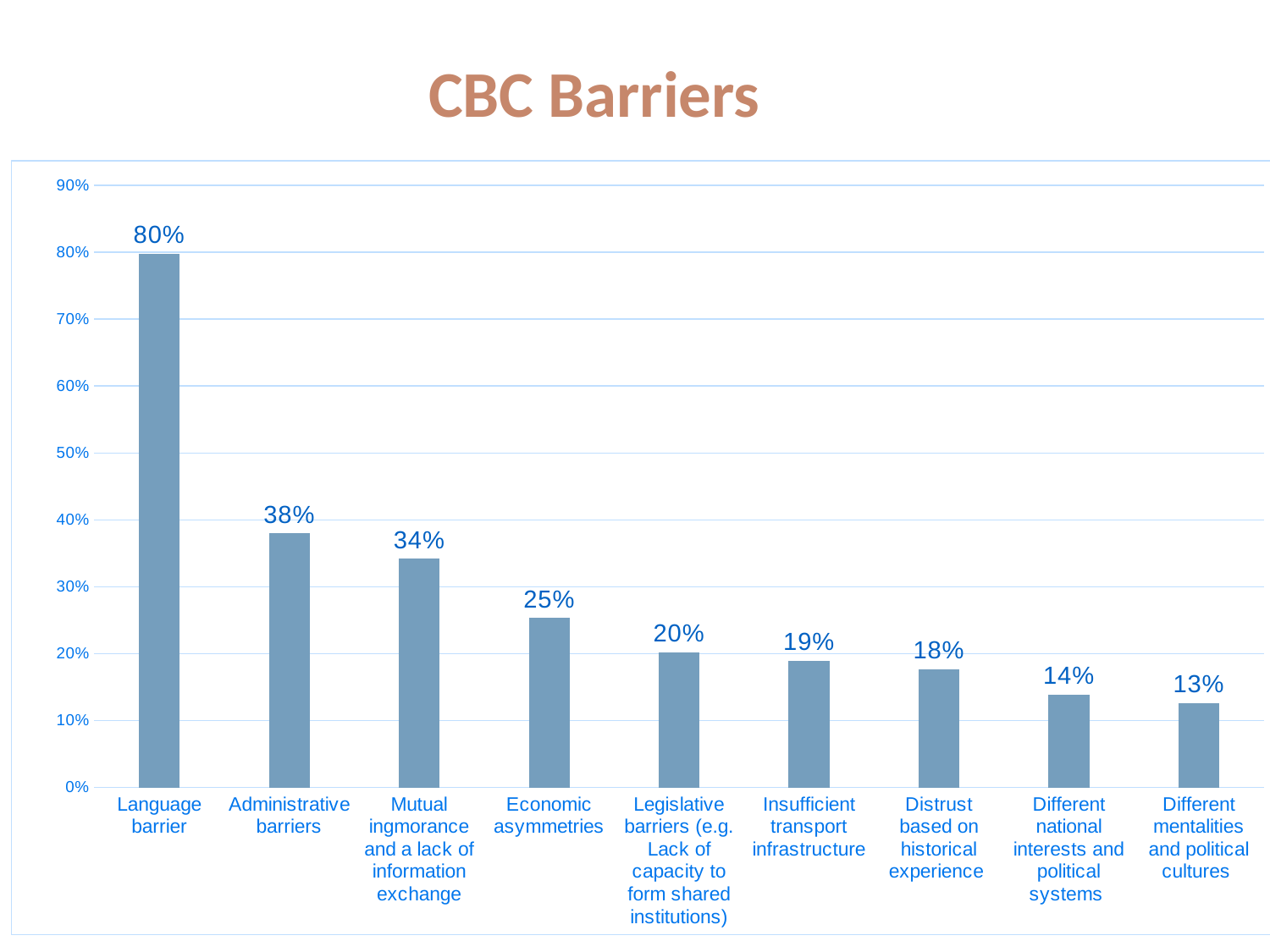
What is the difference between the values for Language barrier and Administrative barriers? 42% What is the value for Insufficient transport infrastructure? 19% Do the values rise or fall from left to right along the x axis? fall What is the difference between the values for Mutual ingmorance and a lack of information exchange and Economic asymmetries? 9% What kind of chart is shown on the slide? bar chart Which barrier has the lowest value? Different mentalities and political cultures Which is larger, the value for Administrative barriers or the value for Distrust based on historical experience? Administrative barriers Is the value for Legislative barriers (e.g. Lack of capacity to form shared institutions) greater or less than 30%? less Which barrier has the highest value? Language barrier What is the value for Language barrier? 80% How many barrier categories are shown in the chart? 9 What is the value for Economic asymmetries? 25%